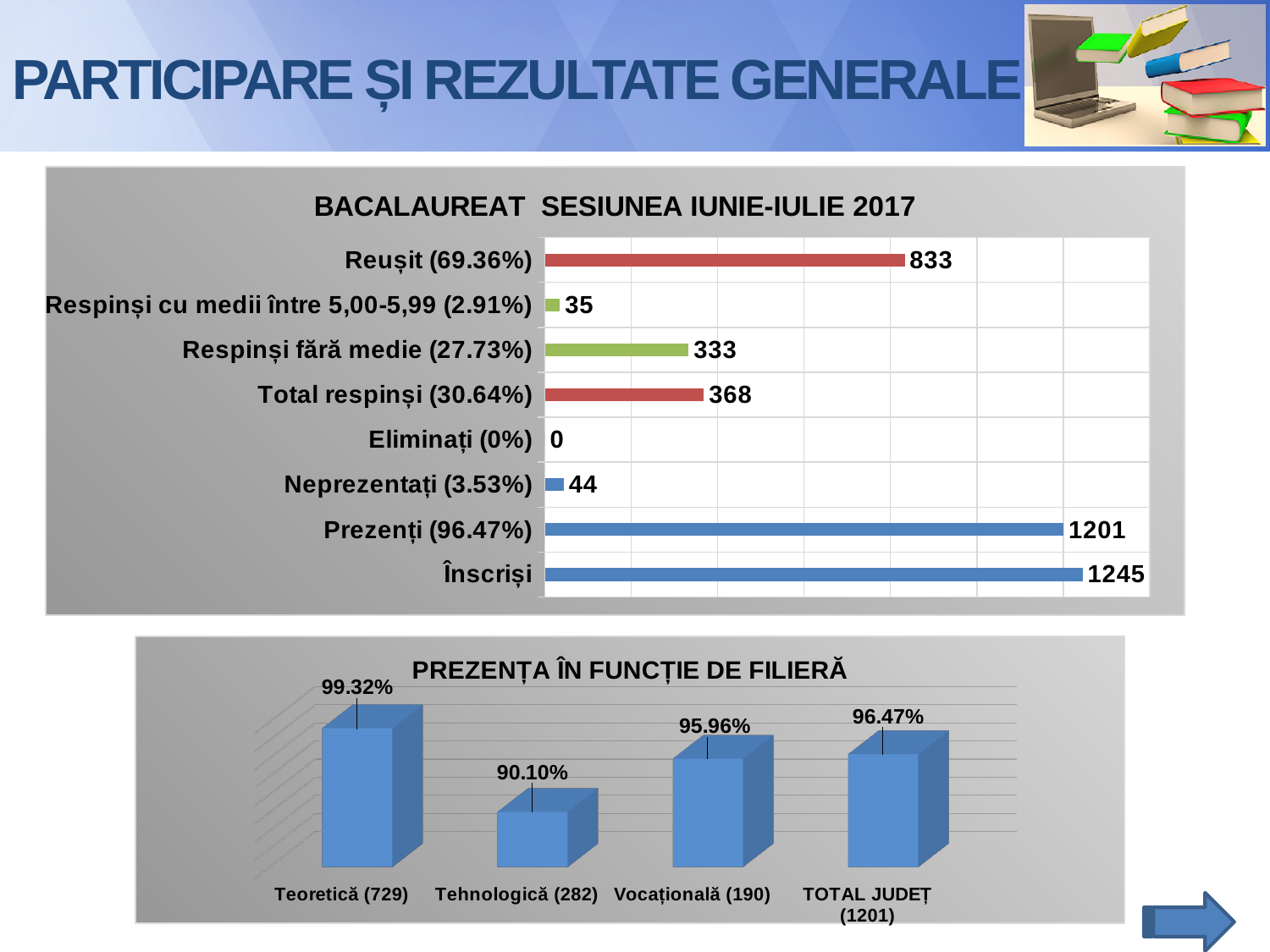
In the chart titled 'PREZENȚA ÎN FUNCȚIE DE FILIERĂ', what is the difference between Teoretică (729) and Tehnologică (282)? 9.22% In the chart titled 'PREZENȚA ÎN FUNCȚIE DE FILIERĂ', which category has the highest value? Teoretică (729) In the chart titled 'BACALAUREAT SESIUNEA IUNIE-IULIE 2017', which category has the lowest value? Eliminați (0%) In the chart titled 'BACALAUREAT SESIUNEA IUNIE-IULIE 2017', what is the value for Neprezentați (3.53%)? 44 In the chart titled 'BACALAUREAT SESIUNEA IUNIE-IULIE 2017', what is the value for Reușit (69.36%)? 833 In the chart titled 'PREZENȚA ÎN FUNCȚIE DE FILIERĂ', what is the value for Tehnologică (282)? 90.10% In the chart titled 'BACALAUREAT SESIUNEA IUNIE-IULIE 2017', which category has the highest value? Înscriși In the chart titled 'BACALAUREAT SESIUNEA IUNIE-IULIE 2017', which is larger: Respinși fără medie (27.73%) or Respinși cu medii între 5,00-5,99 (2.91%)? Respinși fără medie (27.73%) What kind of chart is the chart titled 'BACALAUREAT SESIUNEA IUNIE-IULIE 2017'? Bar chart How many categories are shown in the chart titled 'BACALAUREAT SESIUNEA IUNIE-IULIE 2017'? 8 In the chart titled 'BACALAUREAT SESIUNEA IUNIE-IULIE 2017', what is the value for Înscriși? 1245 In the chart titled 'BACALAUREAT SESIUNEA IUNIE-IULIE 2017', what is the difference between Înscriși and Prezenți (96.47%)? 44